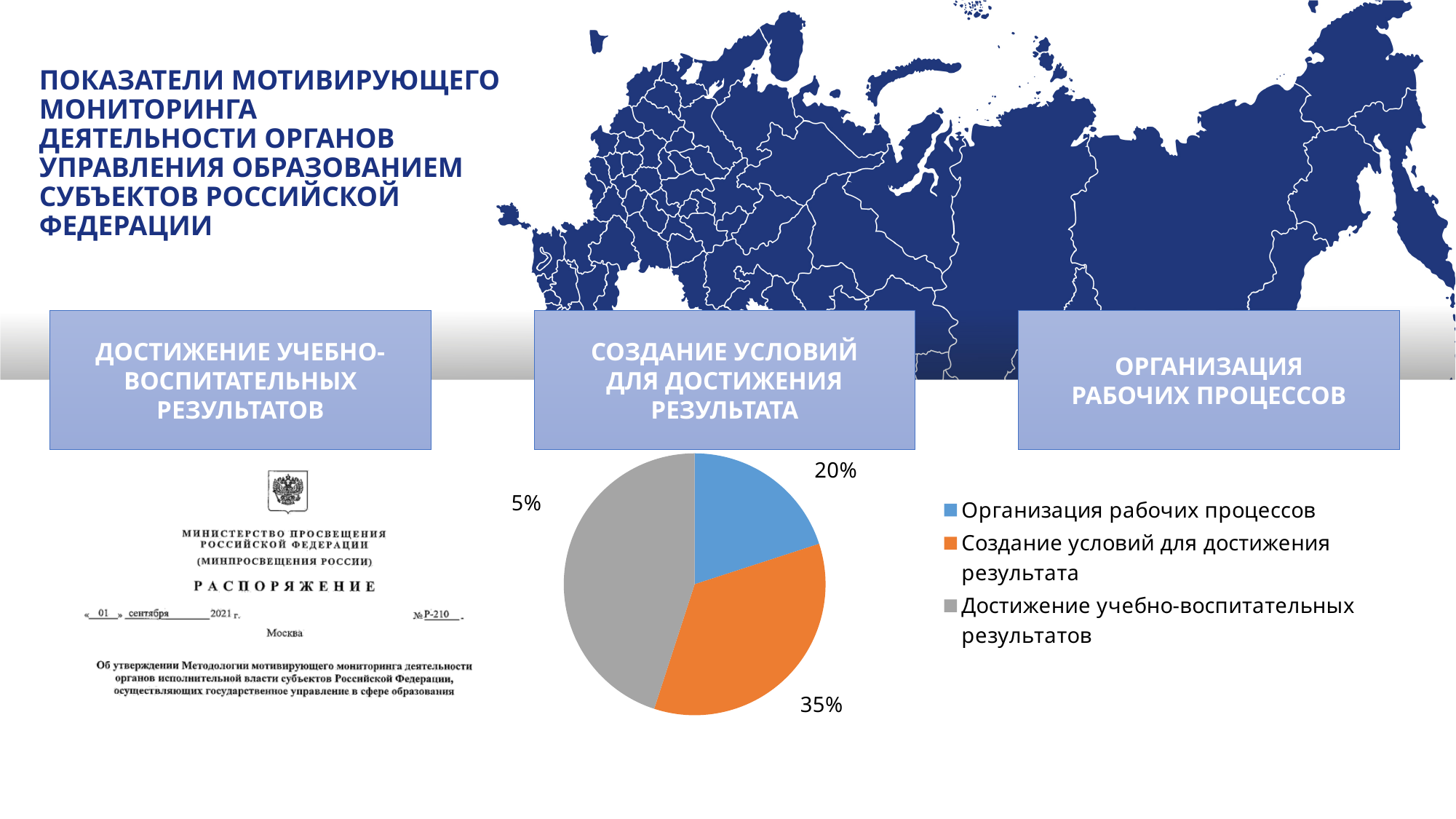
How many entries does the legend of the pie chart list? 3 Which slice is larger: 'Организация рабочих процессов' or 'Создание условий для достижения результата'? Создание условий для достижения результата What percentage is shown for the slice 'Создание условий для достижения результата'? 35% What is the difference between the 'Создание условий для достижения результата' slice and the 'Организация рабочих процессов' slice? 15% How many slices does the pie chart have? 3 What percentage is shown for the slice 'Организация рабочих процессов'? 20% What colour is the 'Организация рабочих процессов' slice in the pie chart? blue What kind of chart is shown on the slide? pie chart Which legend entry is shown in grey in the pie chart? Достижение учебно-воспитательных результатов